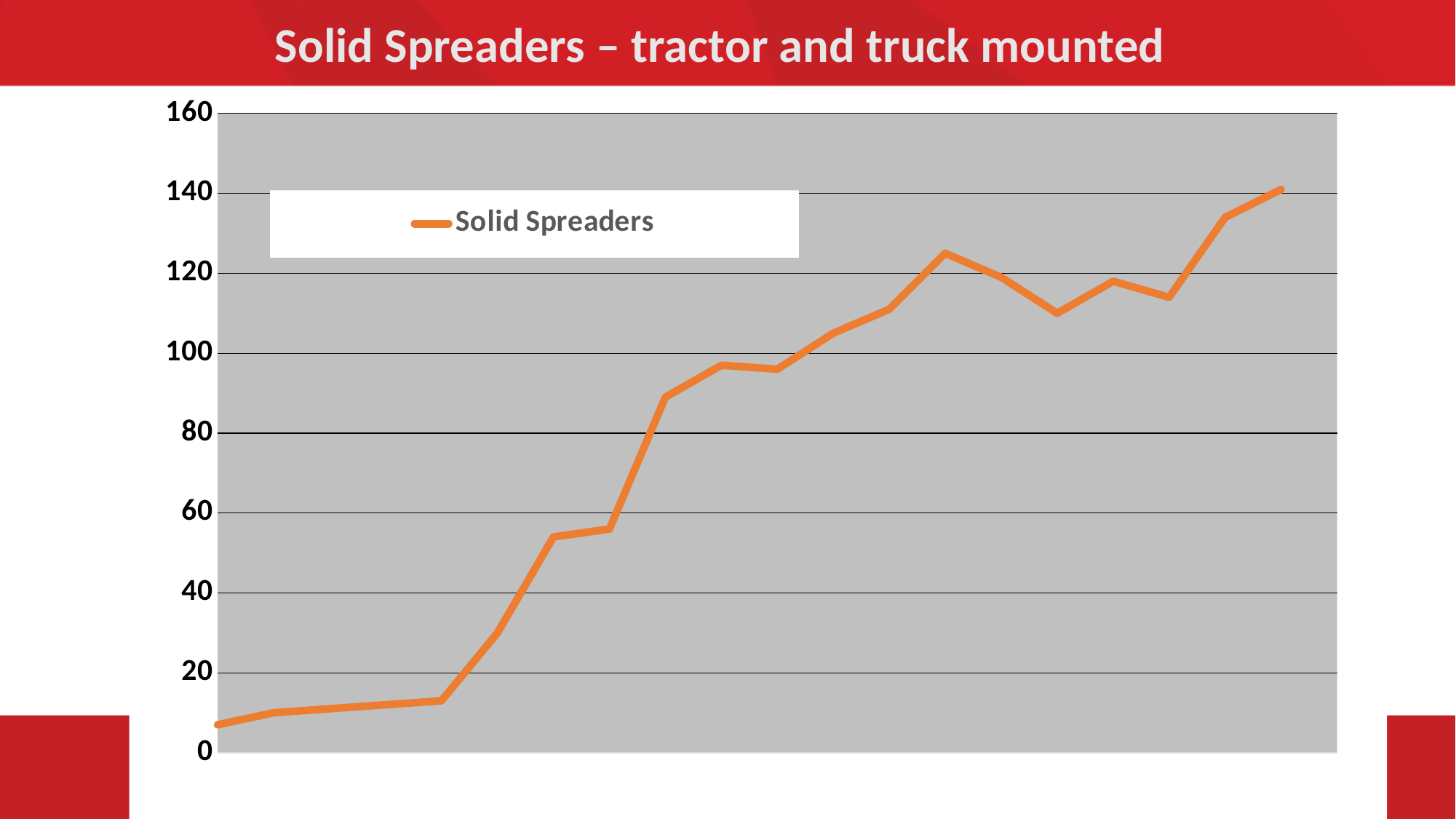
Overall, do the values of the Solid Spreaders line rise or fall from left to right? rise How many series does the legend list? 1 What is the title of the slide containing the chart? Solid Spreaders – tractor and truck mounted Which point on the Solid Spreaders line has the lowest value, the first or the last? the first Is the value of the last point on the Solid Spreaders line greater or less than 120? greater Is the value of the last point on the Solid Spreaders line greater or less than 160? less Is the value of the first point on the Solid Spreaders line greater or less than 20? less What is the name of the series shown in the legend? Solid Spreaders What kind of chart is shown on the slide? line chart What is the highest value shown on the vertical axis? 160